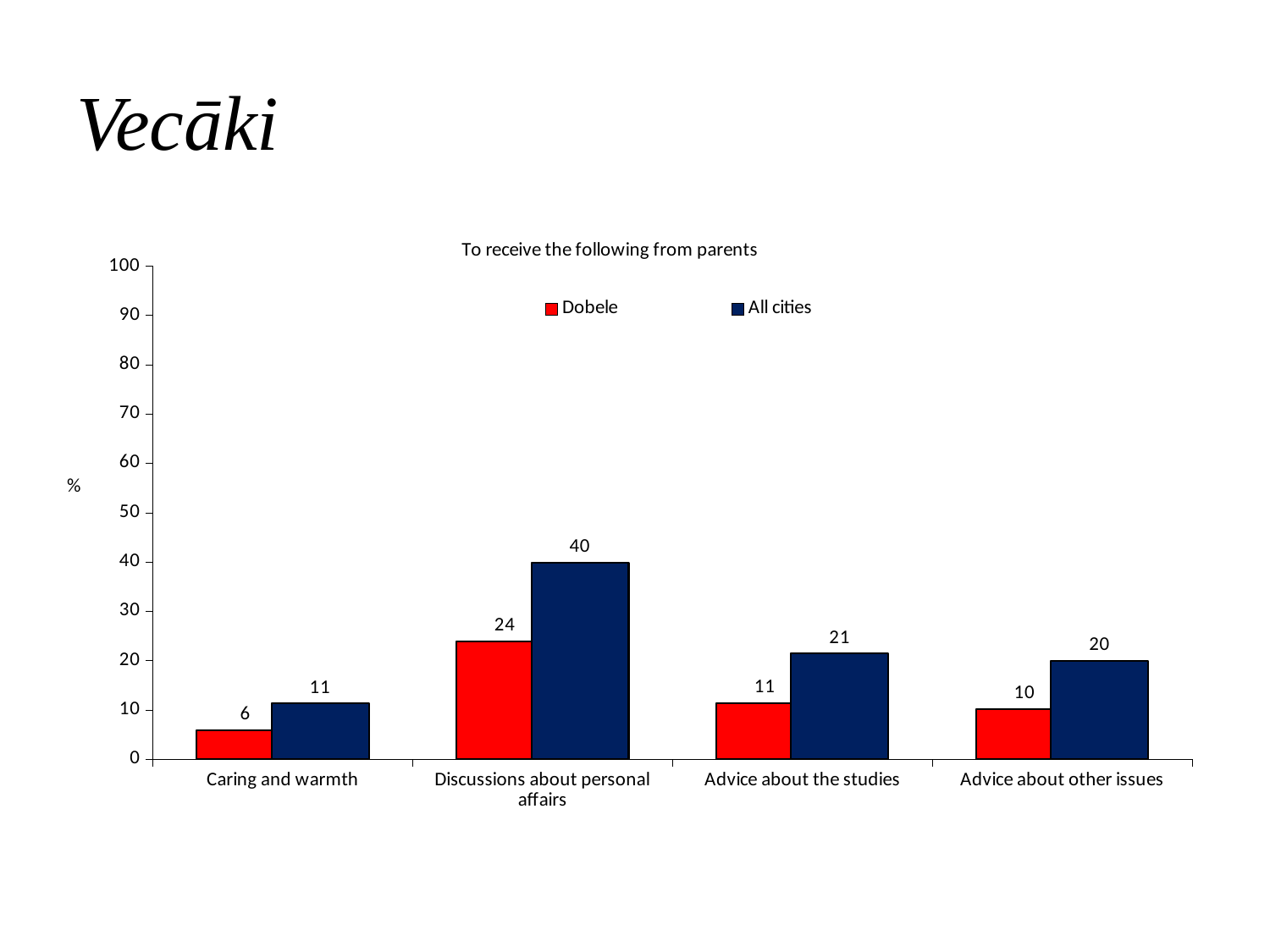
Which category has the highest value for All cities? Discussions about personal affairs Which is larger for Advice about other issues: Dobele or All cities? All cities What kind of chart is shown on the slide? bar chart How many categories are shown on the x axis? 4 What is the title of the chart? To receive the following from parents How many series does the legend list? 2 What is the difference between All cities and Dobele for Discussions about personal affairs? 16 Which category has the lowest value for Dobele? Caring and warmth What is the value for Dobele for Discussions about personal affairs? 24 What is the value for Dobele for Caring and warmth? 6 Is the value for All cities for Caring and warmth greater or less than 20? less What is the value for All cities for Advice about the studies? 21